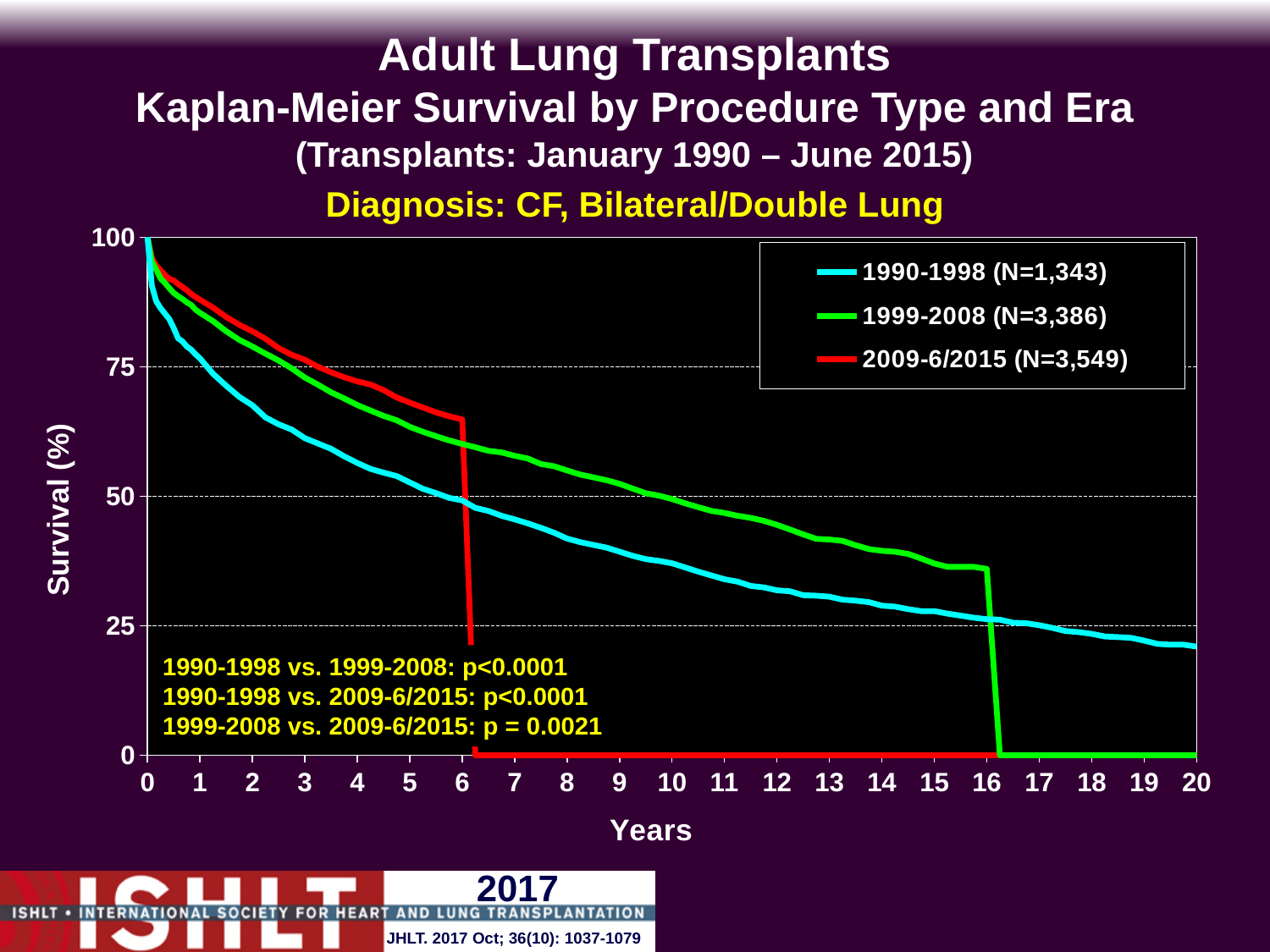
Is the survival value for the 1999-2008 series at year 5 greater or less than 50? greater Is the survival value for the 1990-1998 series at year 10 greater or less than 50? less How many series does the legend list? 3 Is the survival value for the 2009-6/2015 series at year 2 greater or less than 75? greater At year 3, which series has the lowest survival? 1990-1998 What is the survival (%) value at year 0 for the 1990-1998 series? 100 At year 5, which series has the higher survival: 2009-6/2015 or 1990-1998? 2009-6/2015 Do the survival curves rise or fall as years increase? fall What kind of chart is shown on the slide? line chart According to the legend, what is the N for the 1999-2008 series? 3,386 What p-value is shown for 1999-2008 vs. 2009-6/2015? p = 0.0021